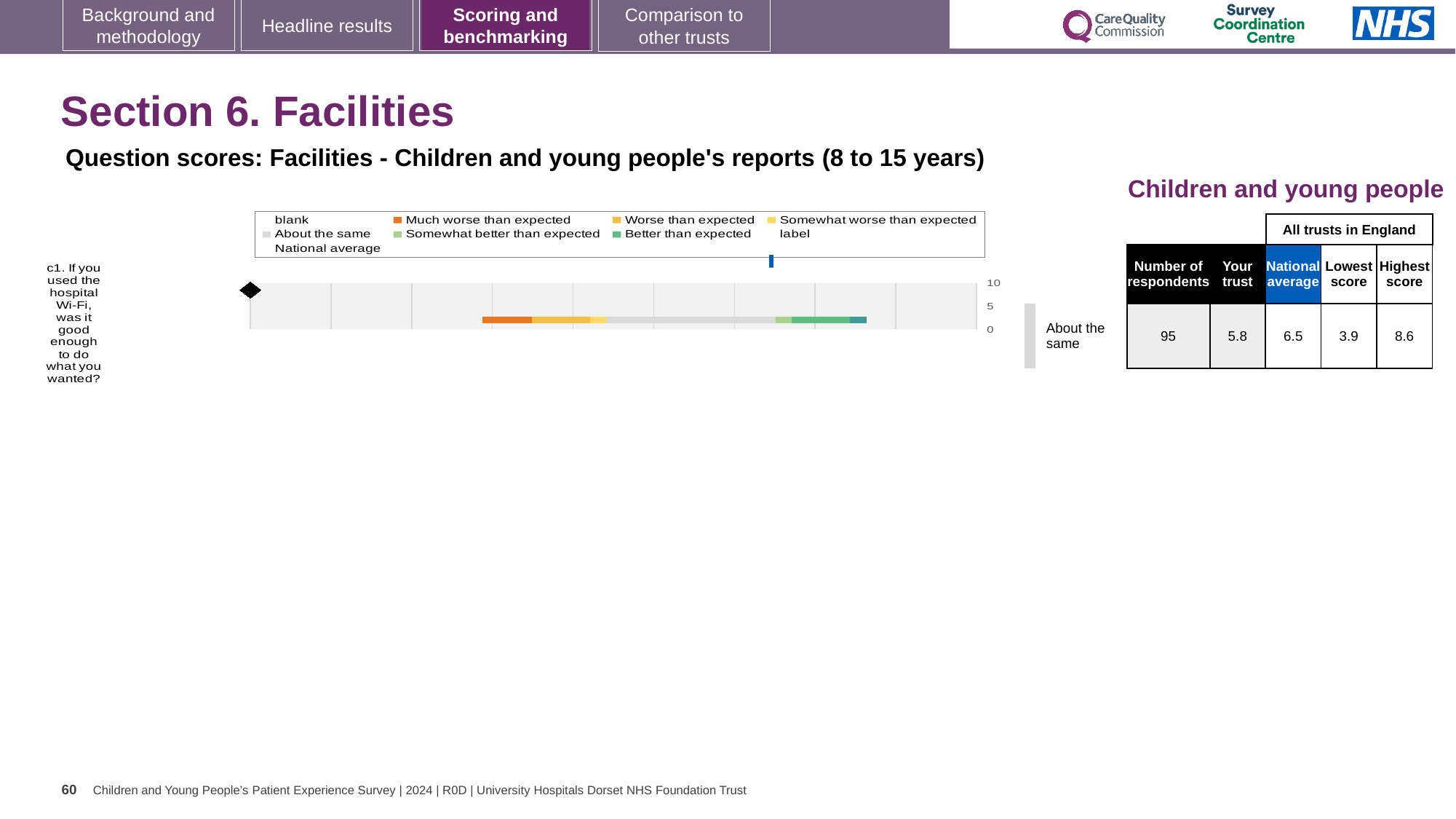
In the table next to the chart, what is the 'Your trust' score for question c1? 5.8 What is the question label for the single bar in the chart? c1. If you used the hospital Wi-Fi, was it good enough to do what you wanted? What kind of chart is shown on the slide? bar chart How many questions (categories) are plotted in the chart? 1 In the table next to the chart, how many respondents answered question c1? 95 What is the difference between the highest score and the lowest score for question c1 in the table? 4.7 Which is larger for question c1: the 'Your trust' score or the national average? National average In the table next to the chart, what is the lowest score among all trusts in England for question c1? 3.9 In the table next to the chart, what is the highest score among all trusts in England for question c1? 8.6 What is the highest tick value shown on the chart's axis? 10 In the table next to the chart, what is the national average score for question c1? 6.5 What colour does the legend use for 'Much worse than expected'? orange